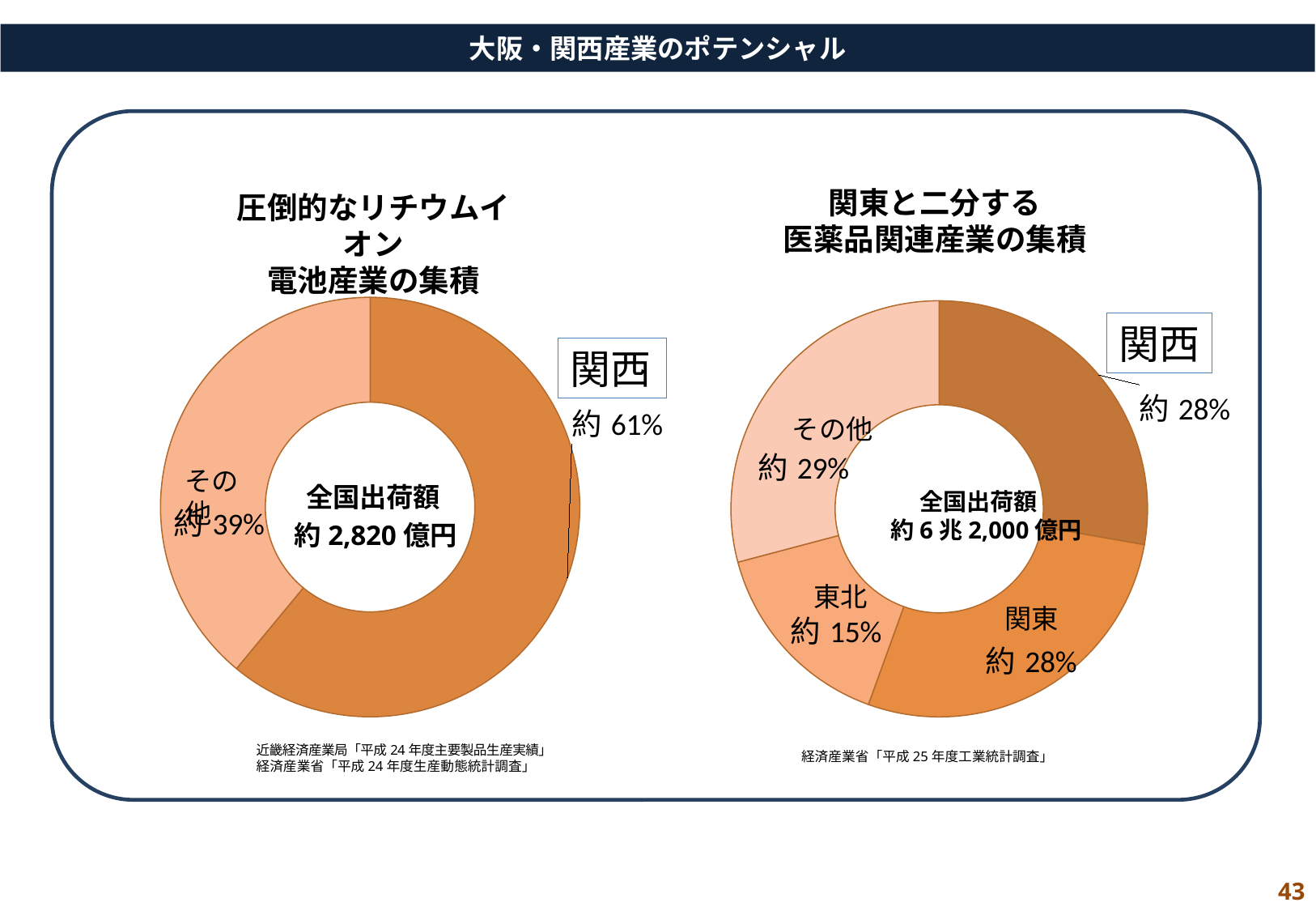
On the left chart (リチウムイオン電池産業), what share is labelled for その他? 約 39% What kind of chart is used on the right (医薬品関連産業)? Pie (donut) chart On the right chart (医薬品関連産業), what is the 全国出荷額 shown in the centre? 約 6 兆 2,000 億円 On the left chart (リチウムイオン電池産業), how many slices does the chart have? 2 On the left chart (リチウムイオン電池産業), how many percentage points larger is 関西 than その他? 22 On the right chart (医薬品関連産業), what share is labelled for 関東? 約 28% On the right chart (医薬品関連産業), which region has the smallest share? 東北 On the right chart (医薬品関連産業), how many percentage points larger is 関東 than 東北? 13 On the right chart (医薬品関連産業), what share is labelled for 東北? 約 15% On the left chart (リチウムイオン電池産業), what share is labelled for 関西? 約 61% On the left chart (リチウムイオン電池産業), which slice is larger, 関西 or その他? 関西 On the left chart (リチウムイオン電池産業), what is the 全国出荷額 shown in the centre? 約 2,820 億円